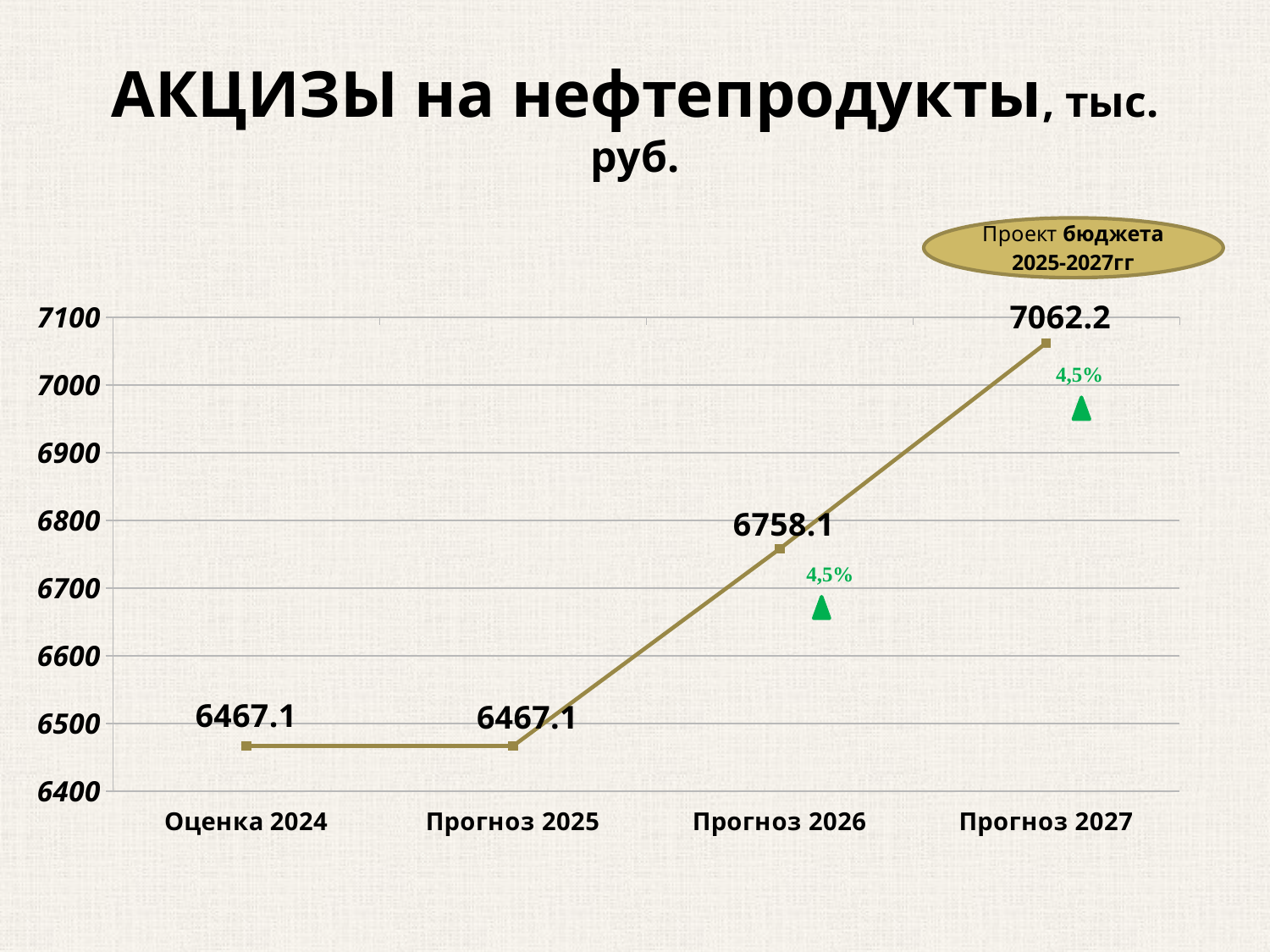
Is the value for Прогноз 2026 greater or less than 6700? greater What is the value for Прогноз 2026? 6758.1 Which is larger, the value for Прогноз 2026 or the value for Прогноз 2027? Прогноз 2027 What is the difference between the values for Прогноз 2027 and Прогноз 2026? 304.1 What is the value for Оценка 2024? 6467.1 What is the value for Прогноз 2027? 7062.2 What is the value for Прогноз 2025? 6467.1 Do the values rise or fall from Прогноз 2025 to Прогноз 2027? rise What is the difference between the values for Прогноз 2026 and Прогноз 2025? 291 How many data points are plotted on the chart? 4 What kind of chart is shown on the slide? line chart Which category has the highest value? Прогноз 2027